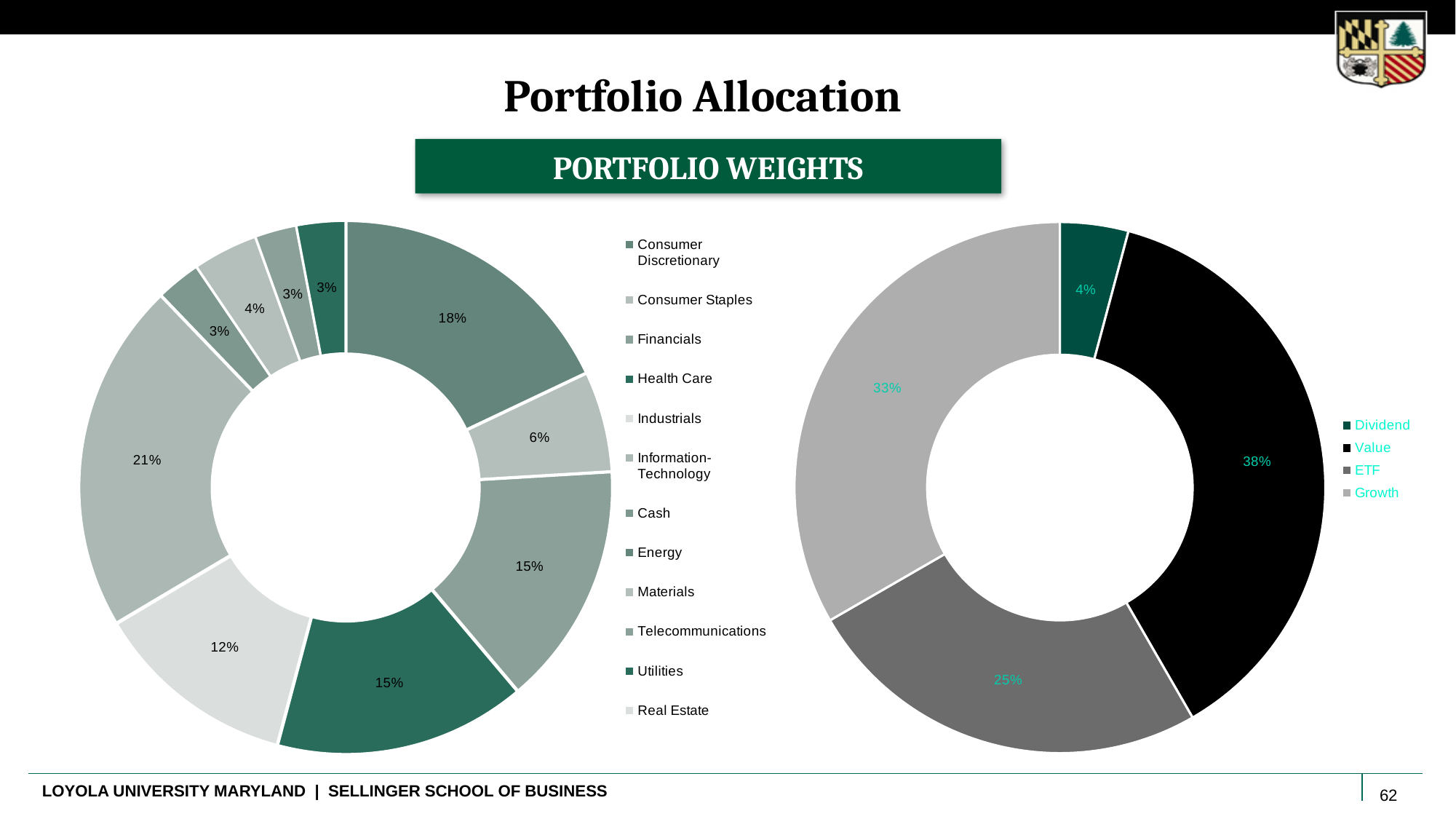
How many entries does the legend of the left chart list? 12 On the right chart, what percentage is allocated to Value? 38% On the right chart, which category has the smallest share? Dividend On the right chart, what percentage is allocated to ETF? 25% On the right chart, what percentage is allocated to Growth? 33% On the right chart, what is the difference between the Value and Growth shares? 5% On the right chart, what percentage is allocated to Dividend? 4% On the right chart, which is larger, ETF or Growth? Growth On the left chart, what is the largest percentage shown on any slice? 21% How many categories does the legend of the right chart list? 4 What type of chart is the left chart? Doughnut (pie) chart On the right chart, which category has the largest share? Value